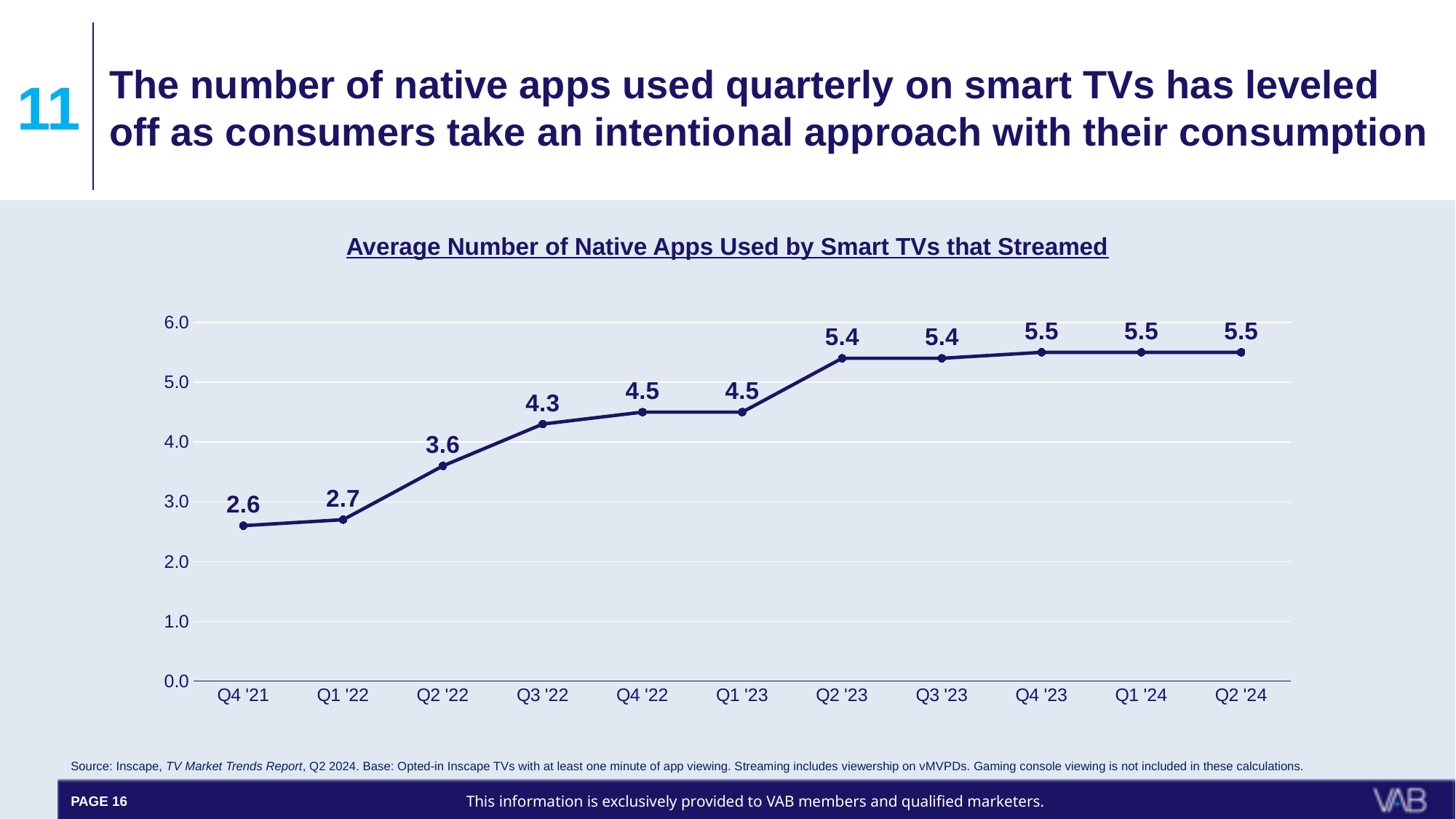
What is the value for Q2 '24? 5.5 What is the value for Q3 '22? 4.3 Is the value for Q4 '22 greater or less than 4.0? greater What is the difference between the values for Q2 '23 and Q2 '22? 1.8 What is the average number of native apps used in Q4 '21? 2.6 How many quarters are plotted on the chart? 11 What is the title of the chart? Average Number of Native Apps Used by Smart TVs that Streamed Do the values generally rise or fall from Q4 '21 to Q2 '24? rise What is the difference between the values for Q2 '24 and Q4 '21? 2.9 Which is larger, the value for Q1 '22 or the value for Q3 '22? Q3 '22 What kind of chart is shown on the slide? line chart Which quarter has the lowest value on the chart? Q4 '21